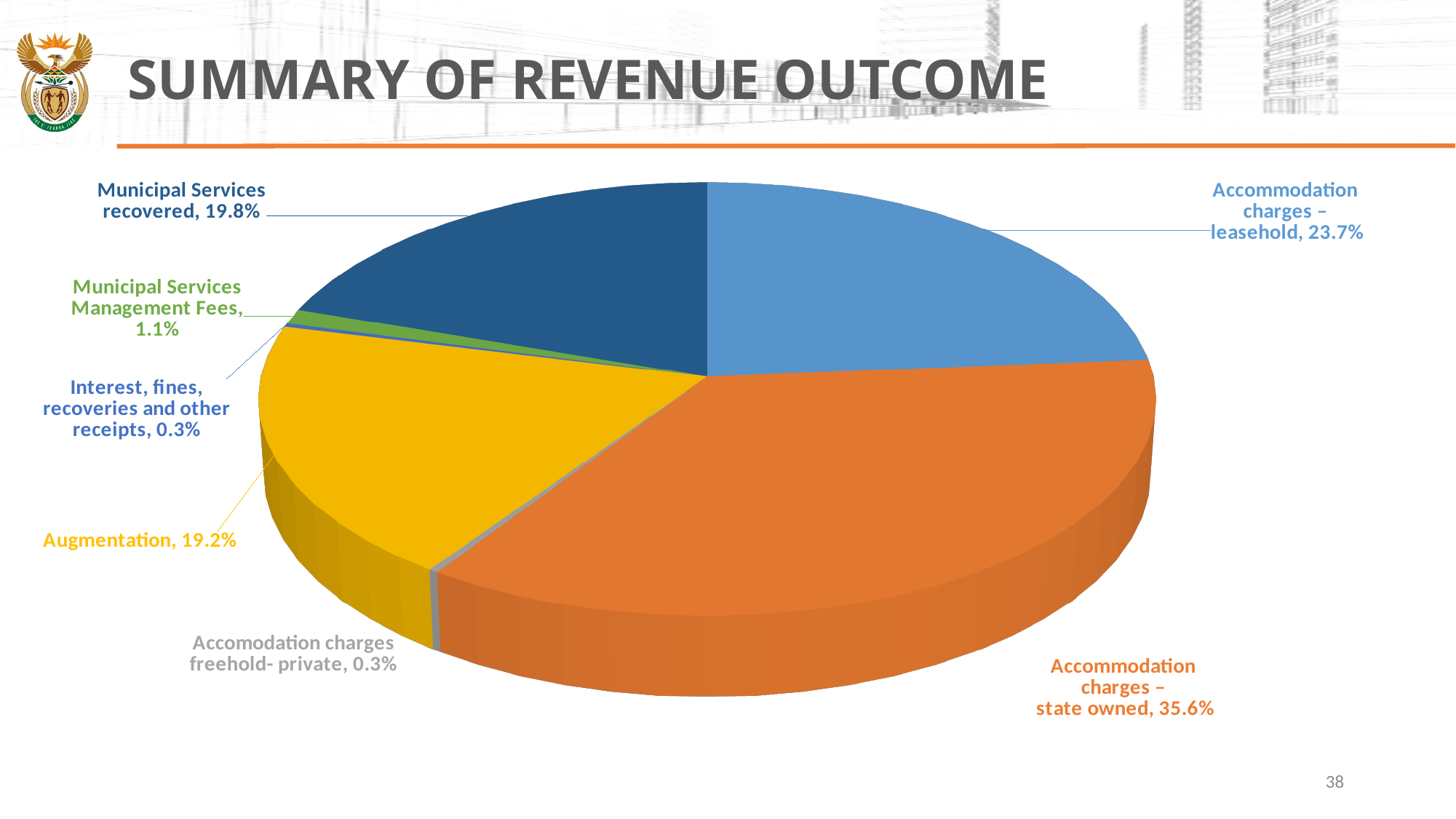
What share of revenue comes from Accommodation charges – state owned? 35.6% What percentage is shown for Municipal Services Management Fees? 1.1% What percentage is shown for Augmentation? 19.2% Which is larger, the share for Accommodation charges – leasehold or the share for Augmentation? Accommodation charges – leasehold What is the difference in percentage points between Accommodation charges – state owned and Accommodation charges – leasehold? 11.9 percentage points What is the title of the slide containing the chart? SUMMARY OF REVENUE OUTCOME What percentage is shown for Interest, fines, recoveries and other receipts? 0.3% What kind of chart is shown on the slide? Pie chart What percentage is shown for Municipal Services recovered? 19.8% What share of revenue comes from Accommodation charges – leasehold? 23.7% How many slices does the pie chart have? 7 Which category has the largest share of the pie? Accommodation charges – state owned